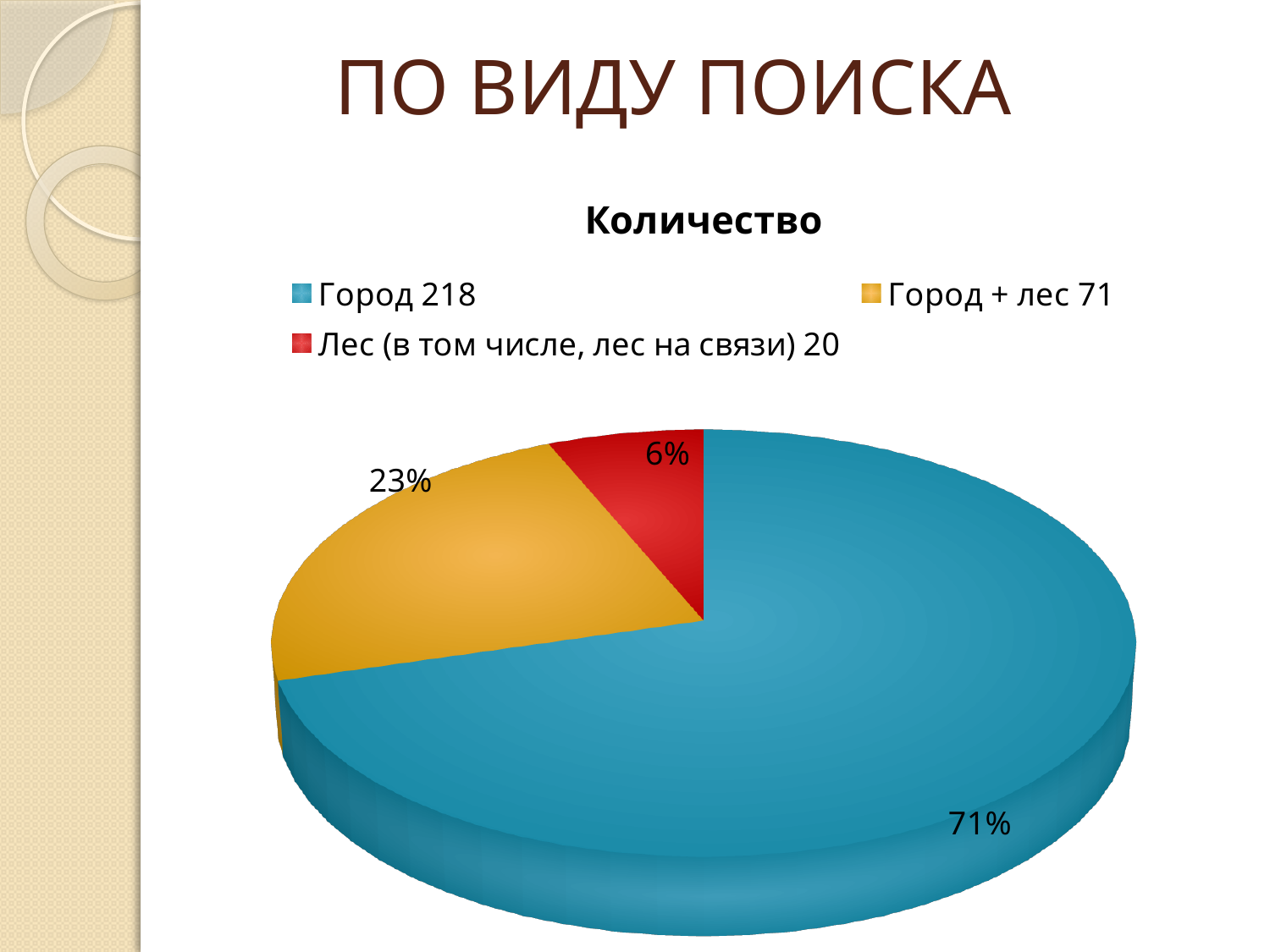
Which category has the smallest slice of the pie? Лес (в том числе, лес на связи) What is the difference in percentage points between the Город slice and the Город + лес slice? 48% What count is shown in the legend for Город + лес? 71 What kind of chart is shown on the slide? pie chart Which category has the largest slice of the pie? Город What count is shown in the legend for Город? 218 What percentage share does the slice for Лес (в том числе, лес на связи) have? 6% What percentage share does the slice for Город have? 71% How many slices does the pie chart have? 3 What count is shown in the legend for Лес (в том числе, лес на связи)? 20 What percentage share does the slice for Город + лес have? 23% What is the title of the chart? Количество